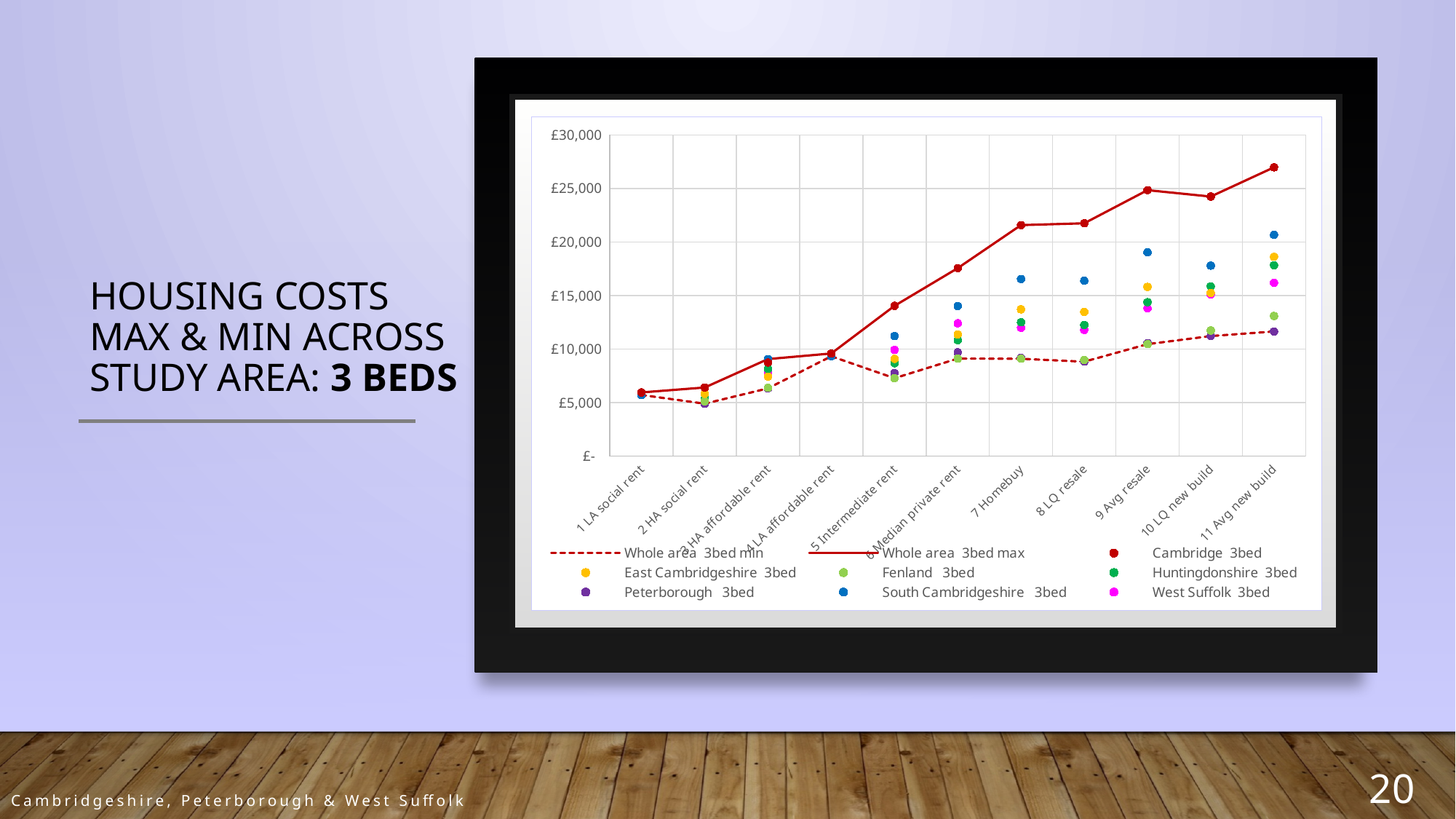
Is the Whole area 3bed max value for 11 Avg new build greater or less than £25,000? greater Which category has the highest value for the Whole area 3bed max series? 11 Avg new build What kind of chart is shown on the slide? line chart Which series is drawn as a dashed line? Whole area 3bed min How many series does the legend list? 9 Is the Whole area 3bed max value for 7 Homebuy greater or less than £20,000? greater Which category has the lowest value for the Whole area 3bed min series? 2 HA social rent Is the Whole area 3bed min value for 8 LQ resale greater or less than £10,000? less How many categories are shown along the x axis? 11 Does the Whole area 3bed max series generally rise or fall from 1 LA social rent to 11 Avg new build? rise Which is larger at 11 Avg new build: the Cambridge 3bed value or the South Cambridgeshire 3bed value? Cambridge 3bed